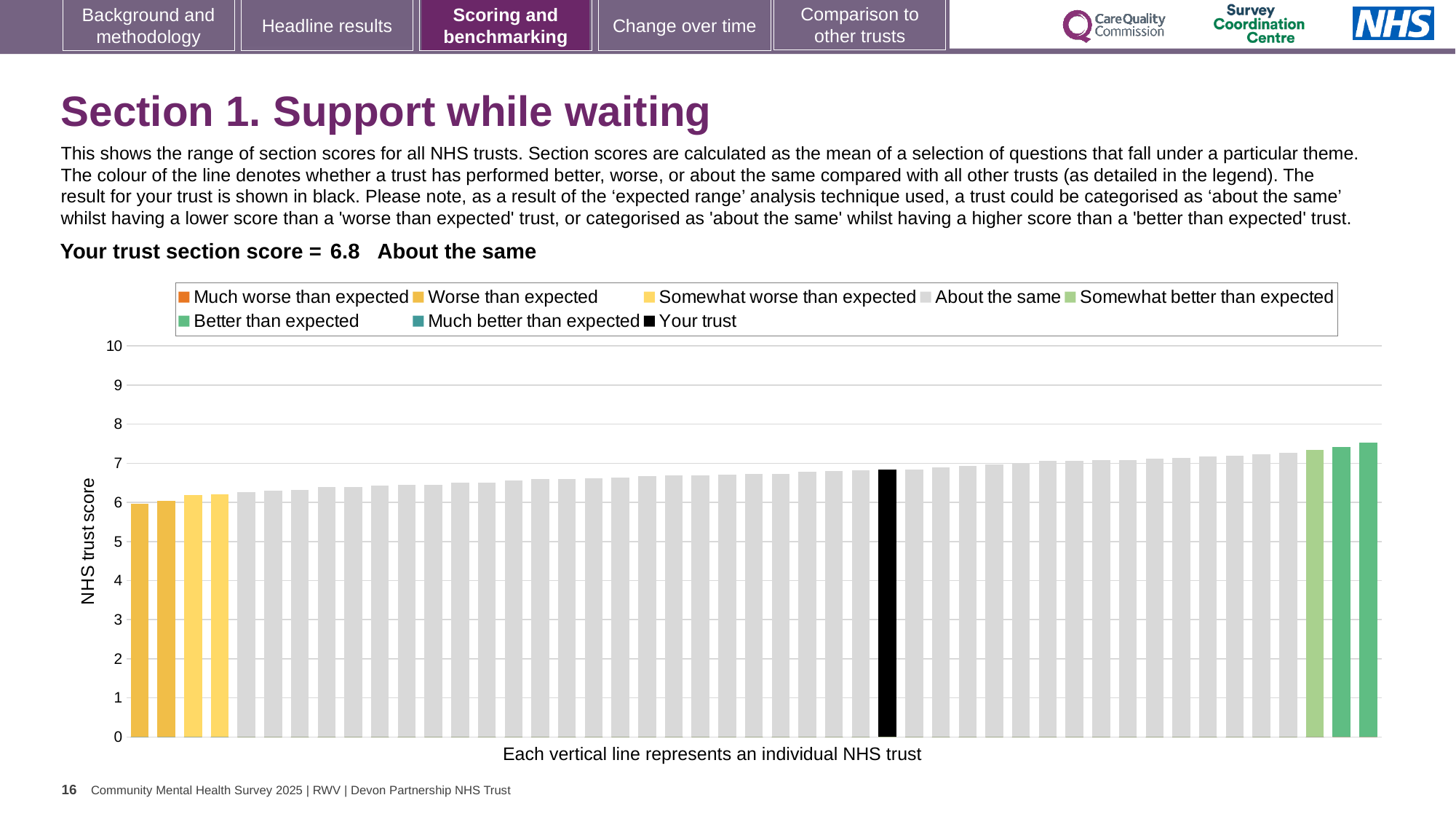
How many bars are coloured as 'Somewhat better than expected'? 1 How many bars are coloured as 'Better than expected'? 2 What is the label on the vertical axis of the chart? NHS trust score What kind of chart is shown on the slide? Bar chart Which category is your trust's section score placed in? About the same Is the value of the leftmost (lowest) bar greater or less than 5? greater Is the value of the black 'Your trust' bar greater or less than 6? greater Which is larger, the score of your trust's bar or the score of the leftmost bar? Your trust What is the section score for your trust shown on the slide? 6.8 How many entries does the chart legend list? 8 Is the value of the rightmost (highest) bar greater or less than 8? less Do the bar values rise or fall from left to right along the x axis? Rise